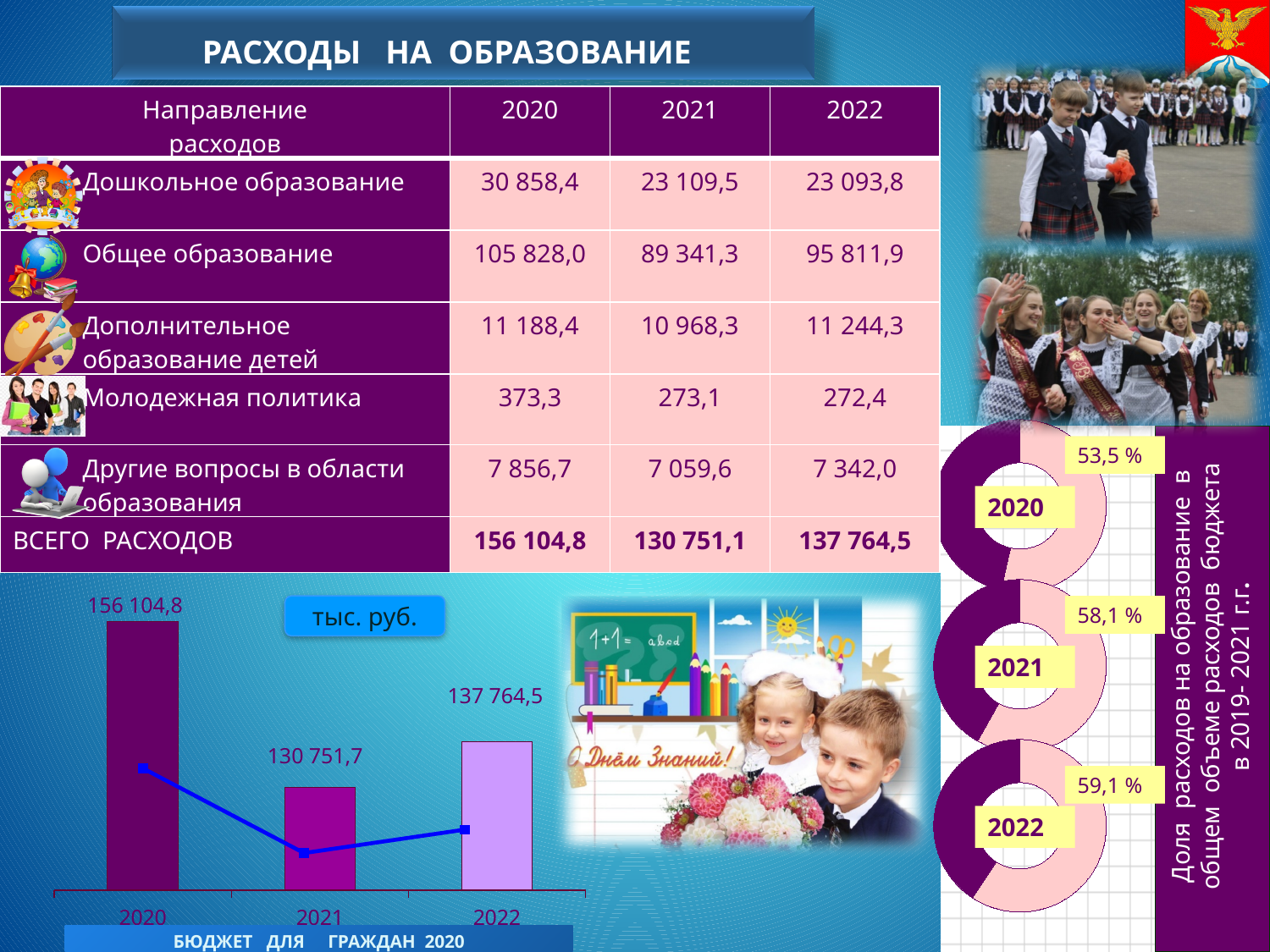
In the bar chart at the bottom left, which year has the lowest value? 2021 In the bar chart at the bottom left, do the values rise or fall from 2020 to 2021? fall What unit is shown in the label next to the bar chart at the bottom left? тыс. руб. How many years are shown on the x axis of the bar chart at the bottom left? 3 In the bar chart at the bottom left, what is the value for 2022? 137 764,5 In the bar chart at the bottom left, what is the value for 2020? 156 104,8 In the bar chart at the bottom left, what is the difference between the values for 2020 and 2021? 25 353,1 In the bar chart at the bottom left, which year has the highest value? 2020 In the bar chart at the bottom left, which is larger: the value for 2021 or the value for 2022? 2022 What kind of chart is shown at the bottom left of the slide? bar chart In the bar chart at the bottom left, what is the difference between the values for 2022 and 2021? 7 012,8 In the bar chart at the bottom left, what is the value for 2021? 130 751,7